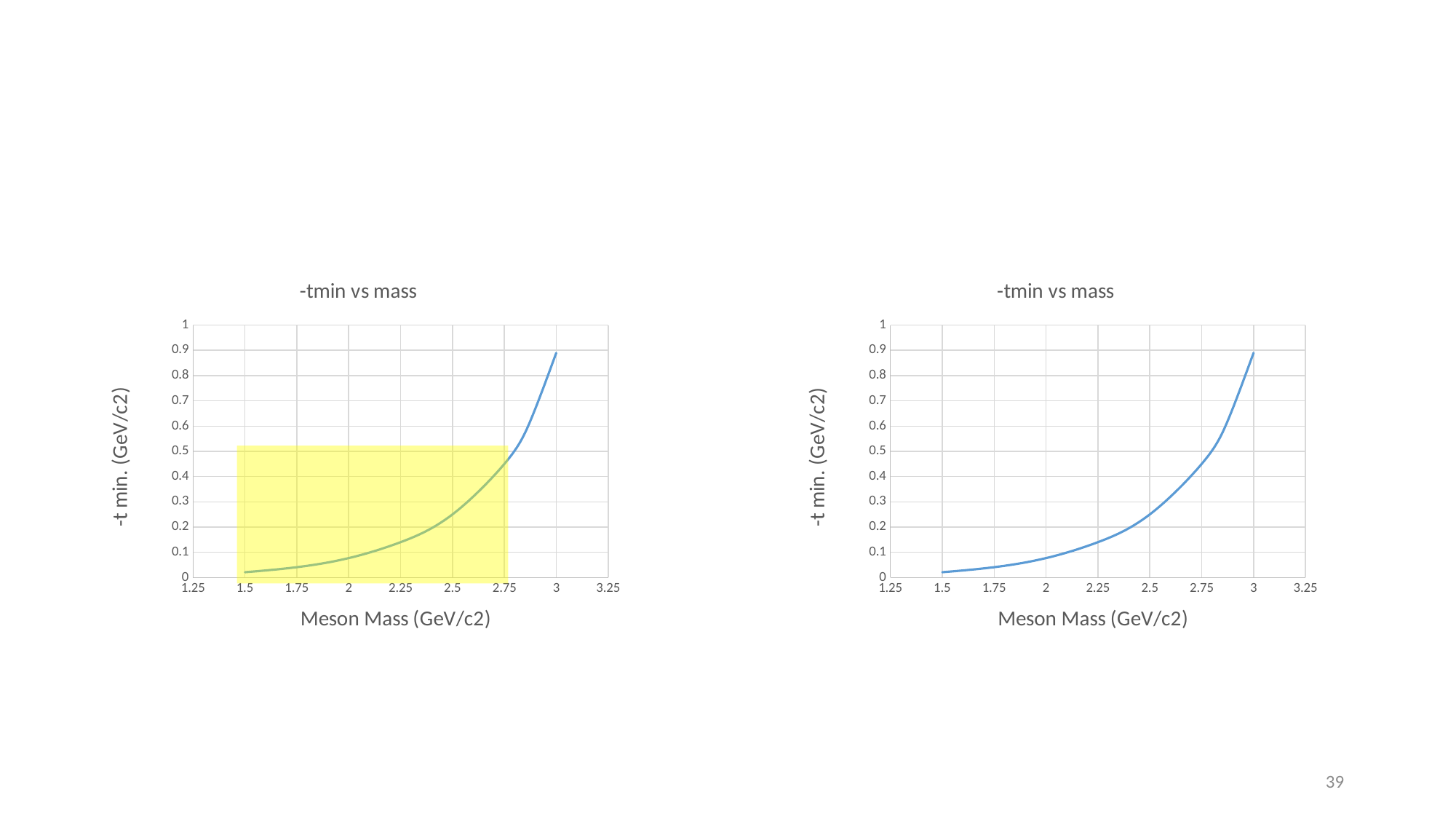
In the left chart, does -t min. rise or fall as meson mass increases? rise In the left chart, is the value of -t min. at a meson mass of 2.5 greater or less than 0.2? greater In the right chart, is the value of -t min. at a meson mass of 2 greater or less than 0.1? less What kind of chart is the left chart titled "-tmin vs mass"? line chart In the left chart, is the value of -t min. at a meson mass of 1.5 greater or less than 0.1? less In the right chart, does -t min. rise or fall as meson mass increases along the x axis? rise What is the y-axis title of the right chart? -t min. (GeV/c2) What kind of chart is the right chart titled "-tmin vs mass"? line chart What is the x-axis title of the left chart? Meson Mass (GeV/c2)